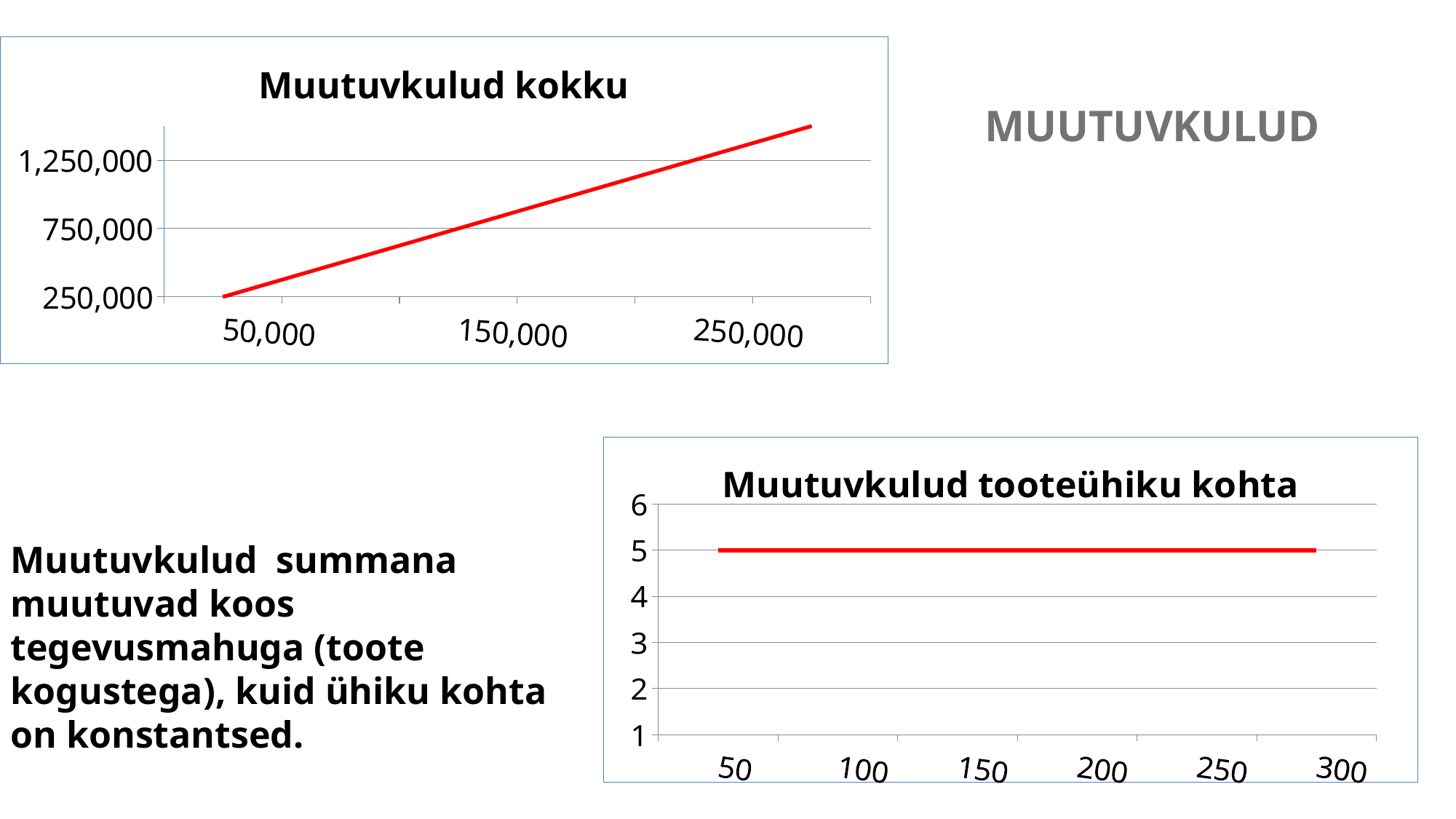
What kind of chart is the "Muutuvkulud kokku" chart? line chart In the "Muutuvkulud kokku" chart, what is the value at 50,000? 250,000 What kind of chart is the "Muutuvkulud tooteühiku kohta" chart? line chart In the "Muutuvkulud kokku" chart, is the value at 100,000 greater or less than 750,000? less What is the title of the chart in the top left of the slide? Muutuvkulud kokku In the "Muutuvkulud tooteühiku kohta" chart, what is the value of the line at 100? 5 In the "Muutuvkulud kokku" chart, what is the value at 150,000? 750,000 In the "Muutuvkulud kokku" chart, is the value at 200,000 greater or less than 750,000? greater In the "Muutuvkulud tooteühiku kohta" chart, do the values rise, fall or stay flat as the x axis increases? stay flat In the "Muutuvkulud kokku" chart, what is the value at 250,000? 1,250,000 In the "Muutuvkulud tooteühiku kohta" chart, what is the value of the line at 250? 5 In the "Muutuvkulud kokku" chart, do the values rise, fall or stay flat as the x axis increases? rise